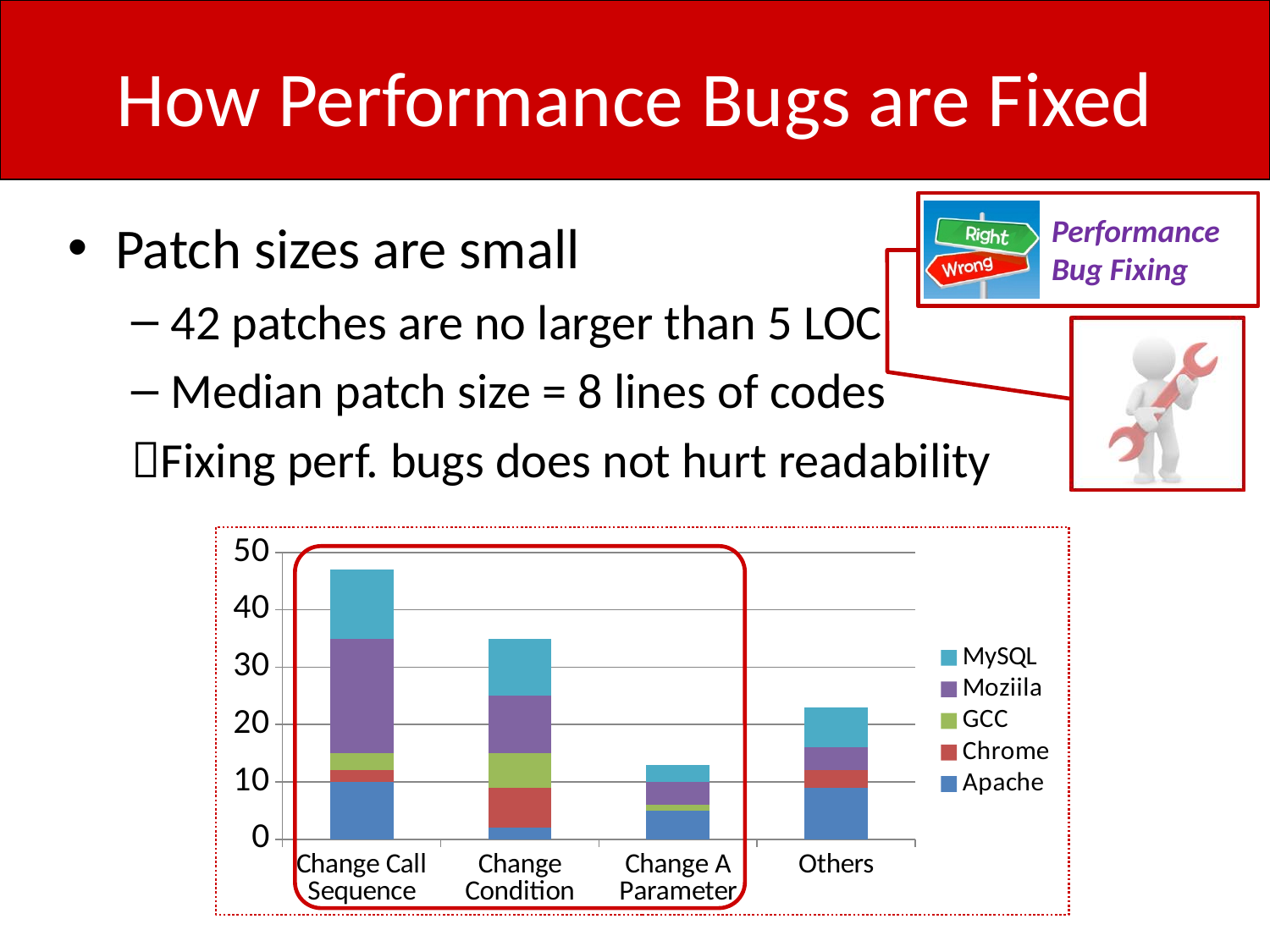
Which series is listed first (at the top) in the chart's legend? MySQL Is the total of the Change A Parameter bar greater or less than 20? less Which category has the shortest stacked bar? Change A Parameter Is the total of the Change Condition bar greater or less than 30? greater Which series forms the bottom segment of each stacked bar? Apache What kind of chart is shown on the slide? bar chart Is the total of the Others bar greater or less than 20? greater How many categories are shown on the x axis of the chart? 4 Which stacked bar is taller, Change Condition or Others? Change Condition Which category has the tallest stacked bar? Change Call Sequence How many series does the chart's legend list? 5